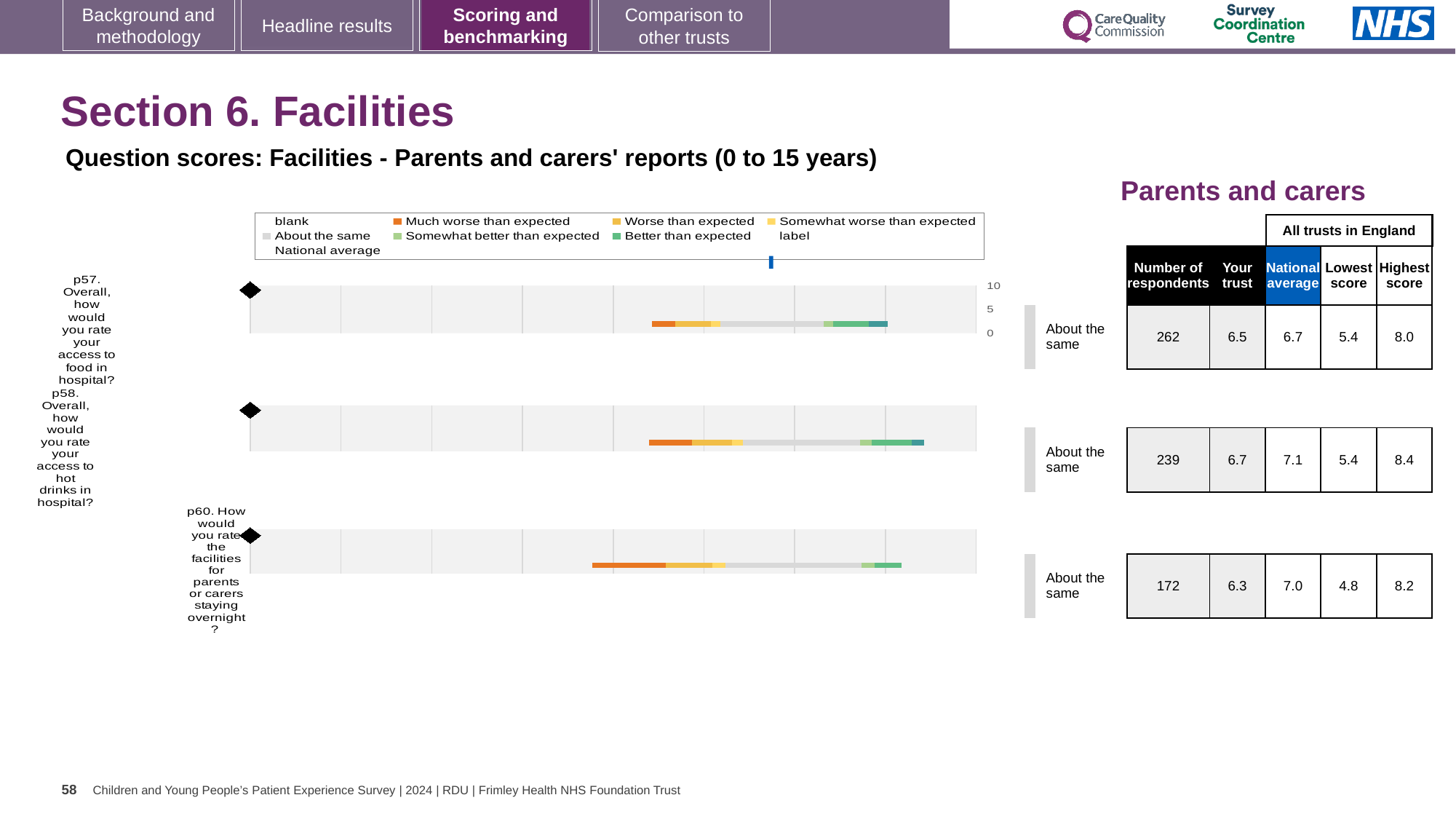
What is the 'Your trust' score for p57 (access to food in hospital)? 6.5 For p60, which is larger: the 'Your trust' score or the national average? National average What is the highest tick value shown on the score axis of the charts? 10 What kind of chart is used to show the question scores on this slide? Bar chart Which question has the lowest 'Your trust' score? p60 (facilities for parents or carers staying overnight) How many respondents answered p60 (facilities for parents or carers staying overnight)? 172 How many questions (p57, p58, p60) are plotted on the slide? 3 What benchmark category is shown for p57 (access to food in hospital)? About the same What is the national average score for p58 (access to hot drinks in hospital)? 7.1 Which question has the highest 'Your trust' score? p58 (access to hot drinks in hospital) Which colour in the legend represents 'Much worse than expected'? Orange For p57, what is the difference between the highest score and the lowest score across all trusts in England? 2.6